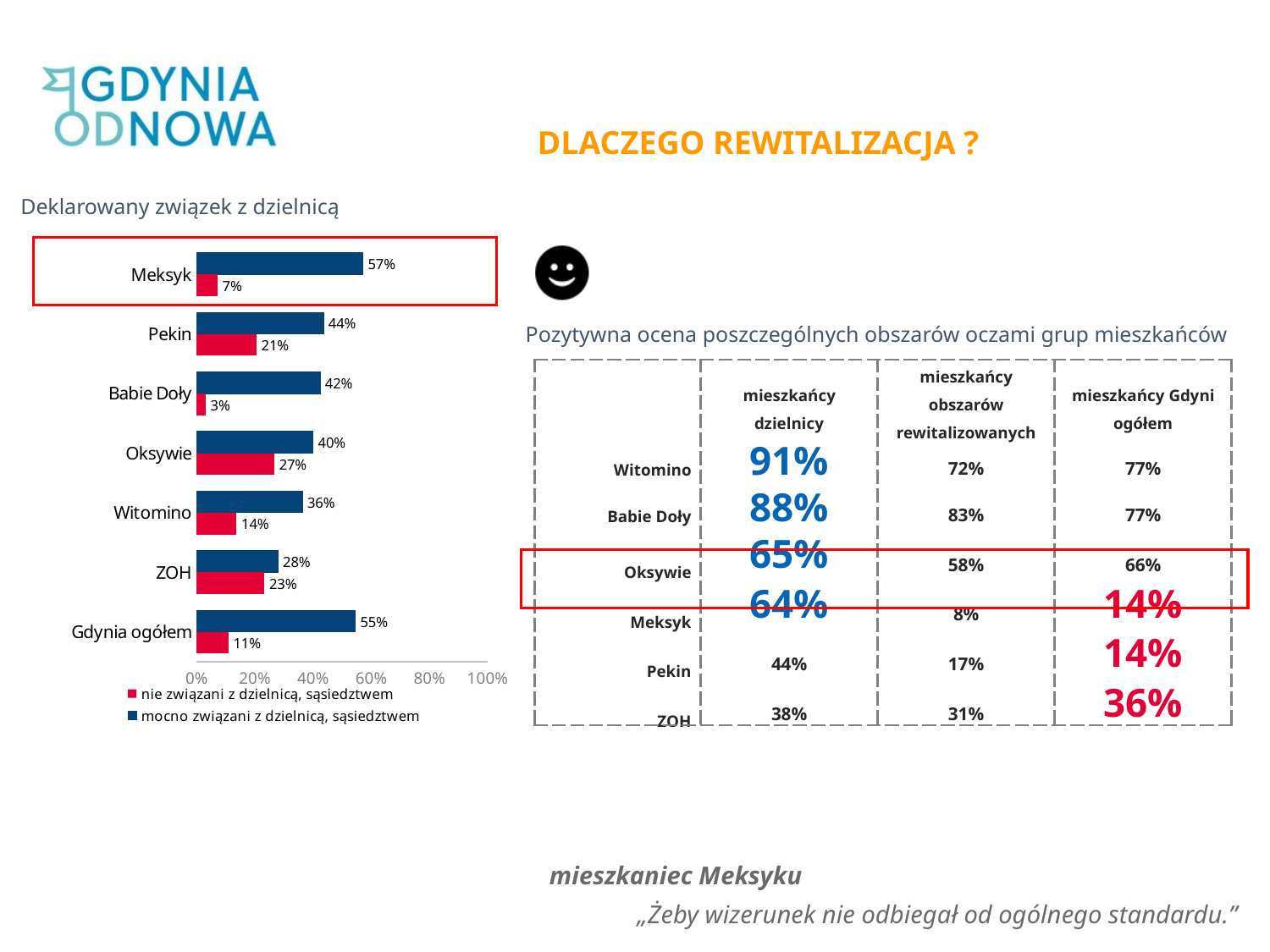
In the chart 'Deklarowany związek z dzielnicą', what is the difference between the 'mocno związani' and 'nie związani' values for Pekin? 23% How many series does the legend of the chart 'Deklarowany związek z dzielnicą' list? 2 In the chart 'Deklarowany związek z dzielnicą', which category has the lowest value in the series 'mocno związani z dzielnicą, sąsiedztwem'? ZOH In the chart 'Deklarowany związek z dzielnicą', which is larger: the 'mocno związani' value for Witomino or for Oksywie? Oksywie In the chart 'Deklarowany związek z dzielnicą', what is the value for Meksyk in the series 'mocno związani z dzielnicą, sąsiedztwem'? 57% In the chart 'Deklarowany związek z dzielnicą', is the 'mocno związani' value for Gdynia ogółem greater or less than 40%? greater In the chart 'Deklarowany związek z dzielnicą', what is the value for Oksywie in the series 'nie związani z dzielnicą, sąsiedztwem'? 27% In the chart 'Deklarowany związek z dzielnicą', what is the value for Gdynia ogółem in the series 'nie związani z dzielnicą, sąsiedztwem'? 11% How many categories are shown in the chart 'Deklarowany związek z dzielnicą'? 7 In the chart 'Deklarowany związek z dzielnicą', which category has the highest value in the series 'mocno związani z dzielnicą, sąsiedztwem'? Meksyk In the chart 'Deklarowany związek z dzielnicą', which category has the lowest value in the series 'nie związani z dzielnicą, sąsiedztwem'? Babie Doły What kind of chart is 'Deklarowany związek z dzielnicą'? Bar chart